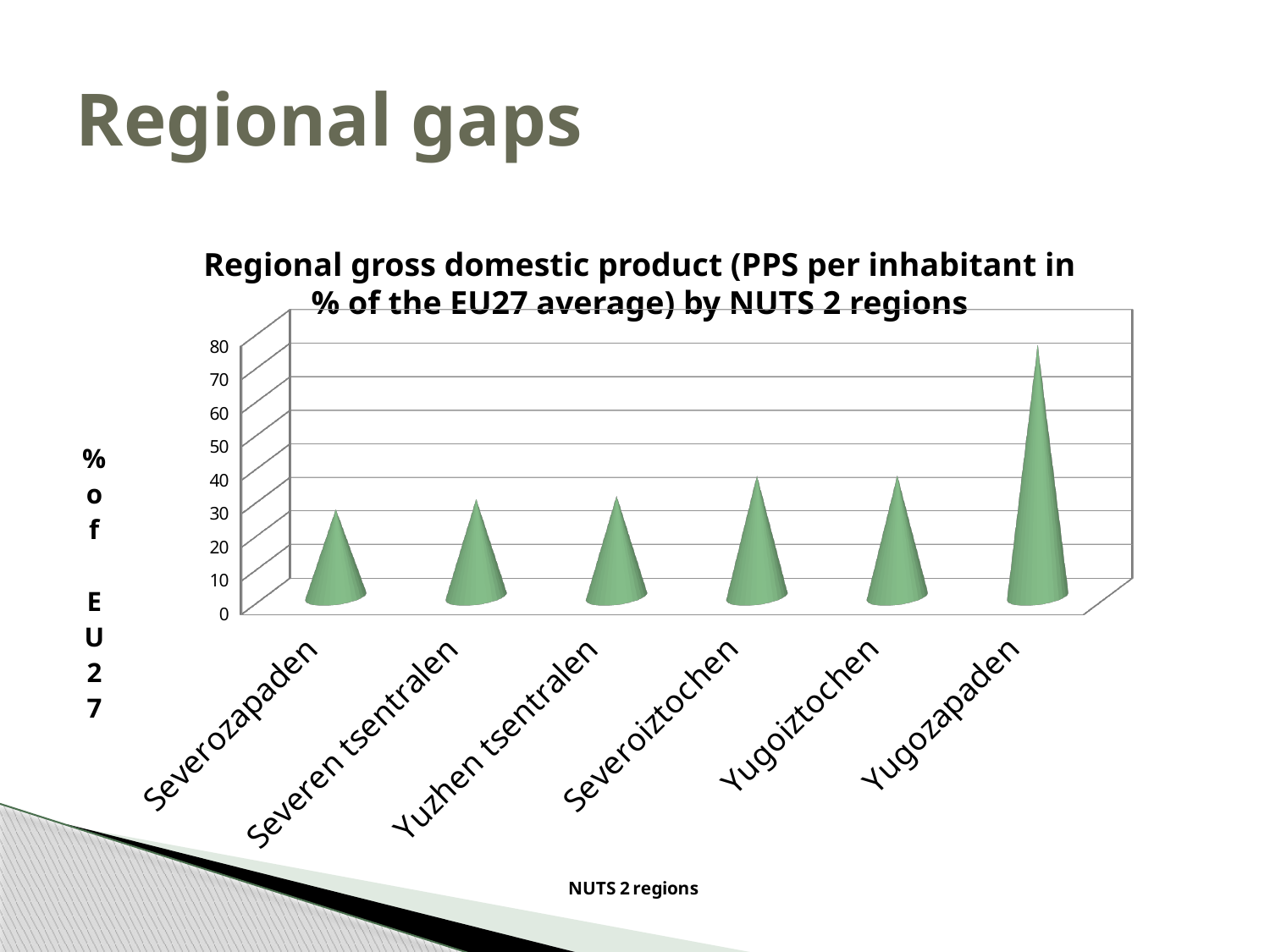
What is the title of the chart? Regional gross domestic product (PPS per inhabitant in % of the EU27 average) by NUTS 2 regions Which is larger, the value for Severoiztochen or the value for Severozapaden? Severoiztochen What is the label of the horizontal axis of the chart? NUTS 2 regions Which is larger, the value for Yugozapaden or the value for Severozapaden? Yugozapaden Is the value for Yuzhen tsentralen greater or less than 50? less Which region has the highest regional GDP value in the chart? Yugozapaden Is the value for Yugozapaden greater or less than 70? greater Is the value for Severoiztochen greater or less than 30? greater How many NUTS 2 regions are plotted in the chart? 6 What kind of chart is shown on the slide? bar chart